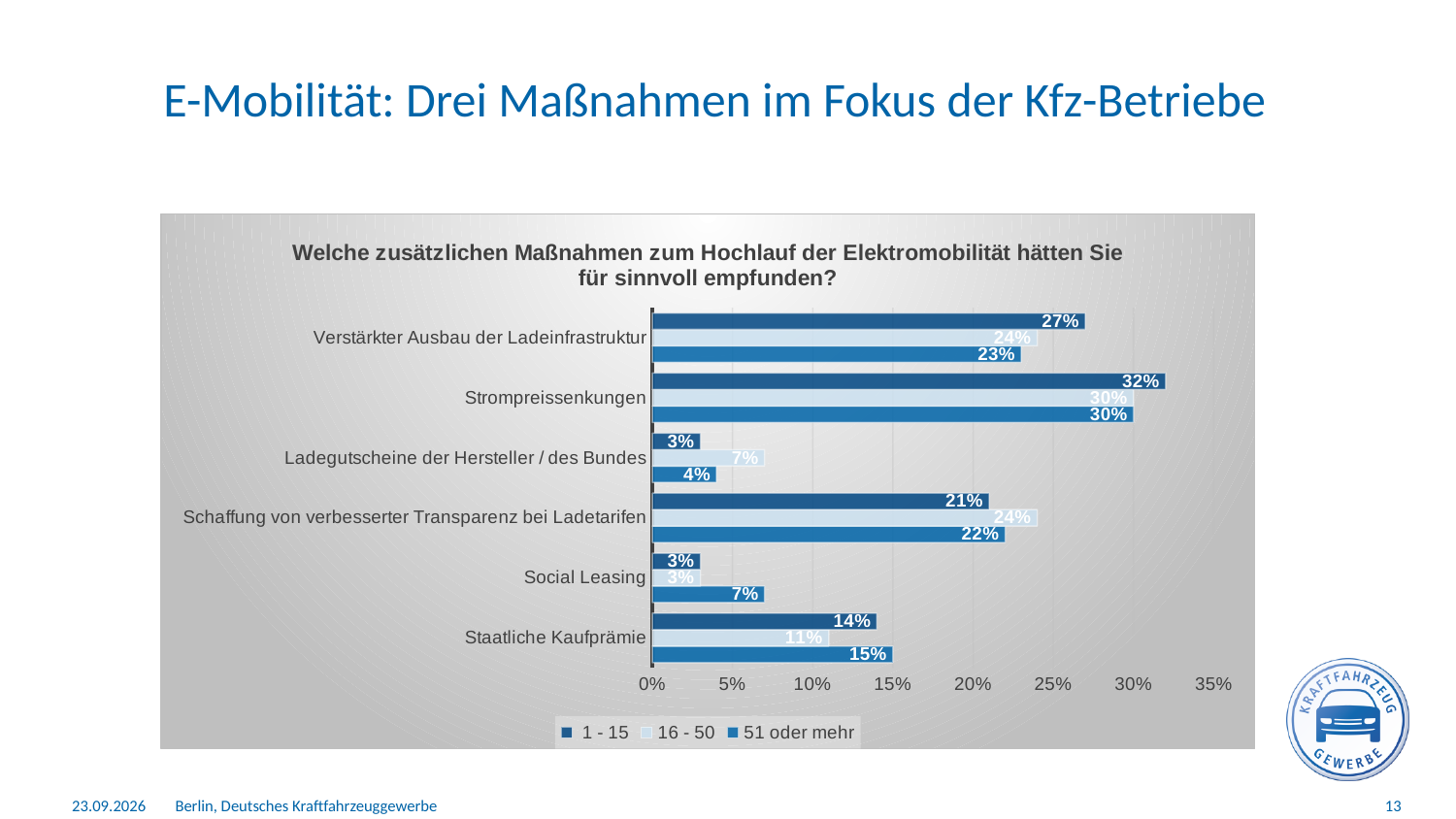
Is the '1 - 15' value for Schaffung von verbesserter Transparenz bei Ladetarifen greater or less than 20%? greater Which category has the highest value in the '1 - 15' series? Strompreissenkungen How many categories are shown on the chart? 6 Which is larger for Ladegutscheine der Hersteller / des Bundes: the '16 - 50' value or the '51 oder mehr' value? 16 - 50 What kind of chart is shown on the slide? Bar chart Which category has the lowest value in the '16 - 50' series? Social Leasing What is the difference between the '1 - 15' and '51 oder mehr' values for Verstärkter Ausbau der Ladeinfrastruktur? 4% What is the value for Staatliche Kaufprämie in the '16 - 50' series? 11% What is the maximum value shown on the x axis of the chart? 35% What is the value for Strompreissenkungen in the '1 - 15' series? 32% How many series does the legend list? 3 What is the value for Social Leasing in the '51 oder mehr' series? 7%